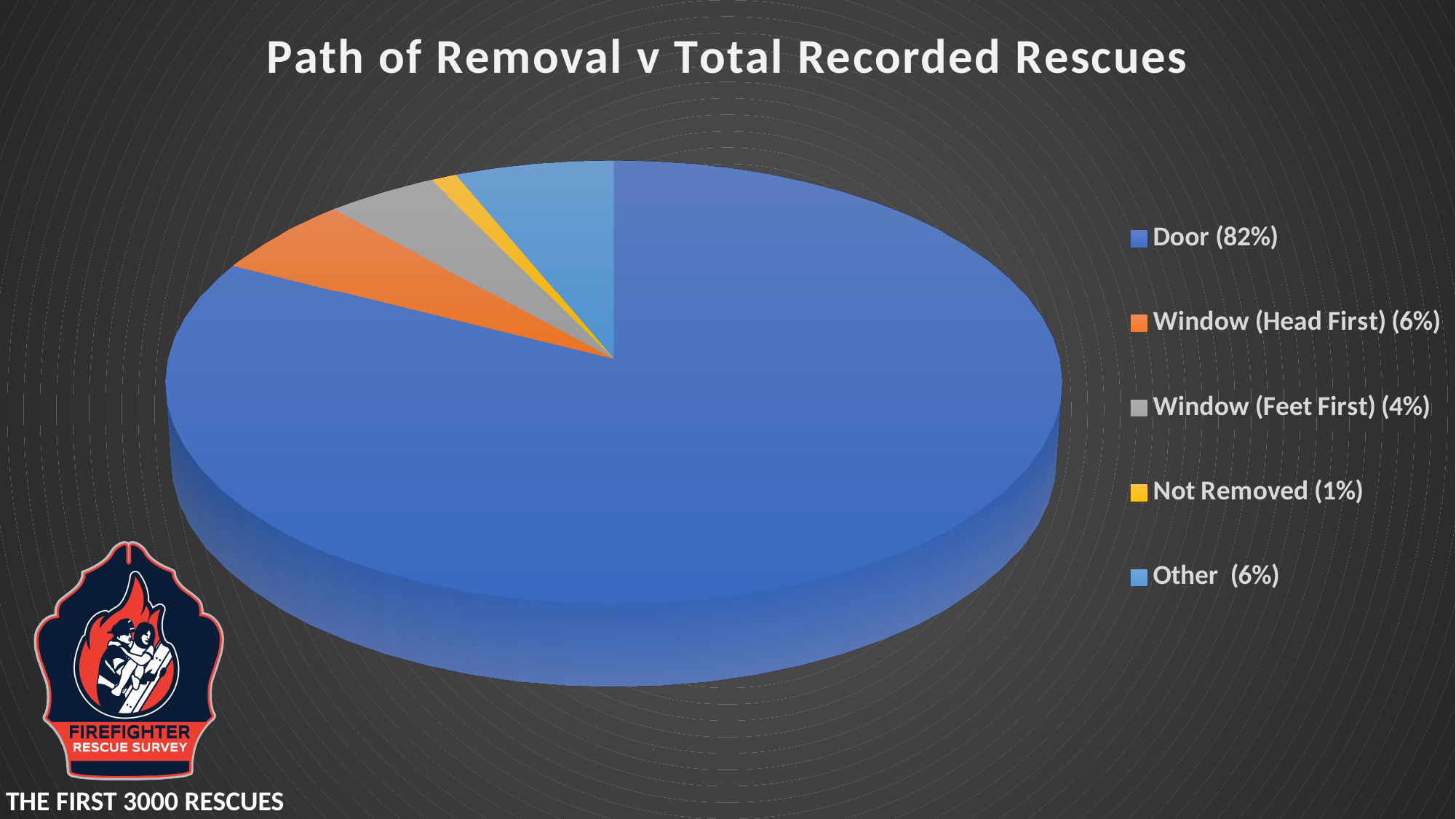
What percentage of rescues were Window (Feet First)? 4% What percentage of rescues fall under Other? 6% Which is larger, the share for Window (Feet First) or the share for Not Removed? Window (Feet First) What is the title of the chart? Path of Removal v Total Recorded Rescues Which path of removal has the largest share of rescues? Door How many categories does the pie chart show? 5 What is the difference in percentage points between Door and Window (Head First)? 76 What percentage of rescues were Not Removed? 1% What percentage of rescues were Window (Head First)? 6% Which category has the smallest share of rescues? Not Removed What percentage of rescues used the Door as the path of removal? 82% What type of chart is shown on the slide? Pie chart